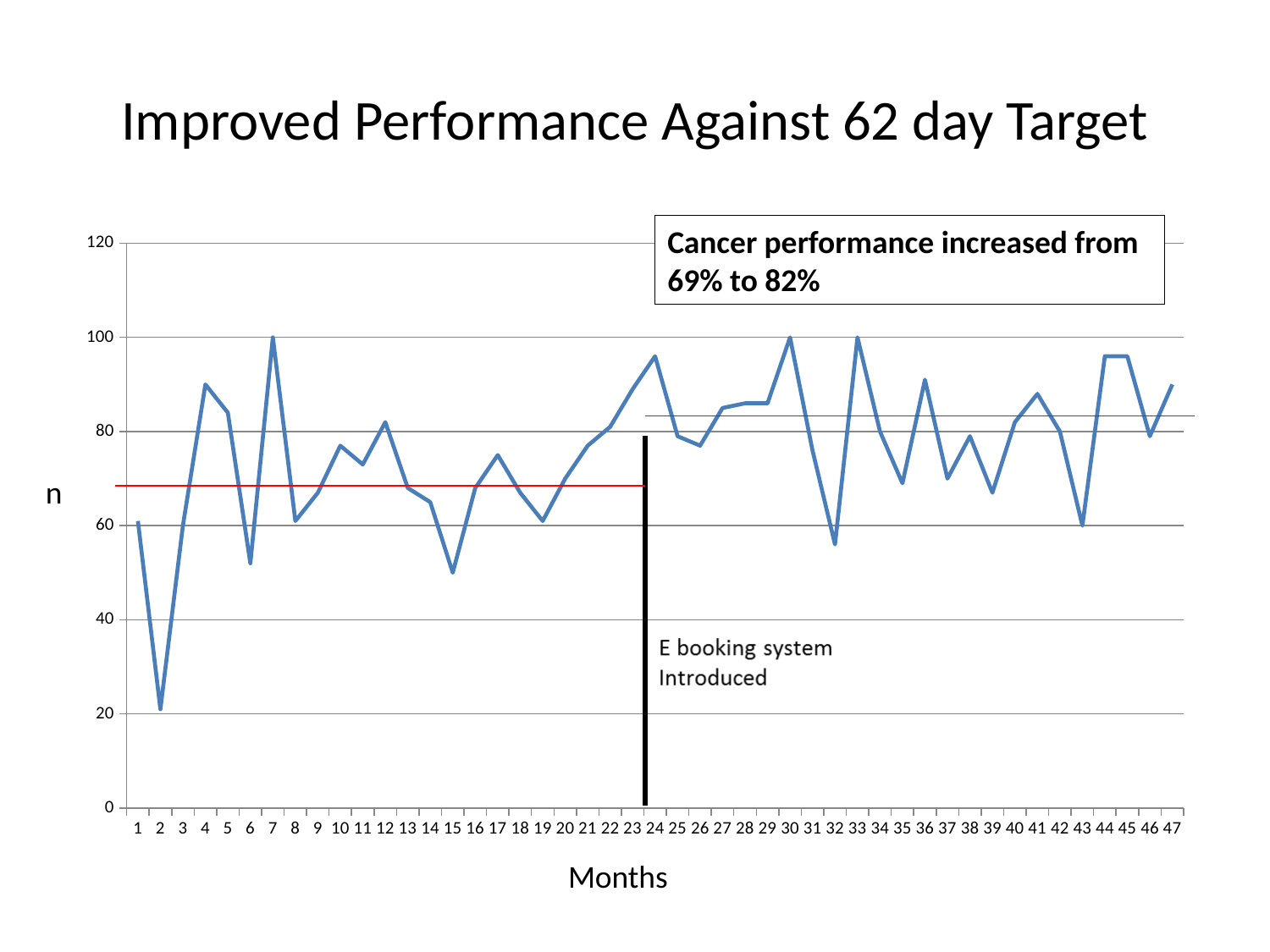
Is the value for month 44 greater or less than 80? greater What is the title of the chart? Improved Performance Against 62 day Target Does the value rise or fall from month 1 to month 2? fall Is the value for month 24 greater or less than 80? greater Is the value for month 15 greater or less than 60? less According to the text box on the chart, cancer performance increased from 69% to what? 82% What is the value for month 7? 100 Which is larger, the value for month 2 or the value for month 7? month 7 How many months are plotted along the x axis? 47 Which month has the lowest value on the chart? 2 What kind of chart is shown on the slide? line chart